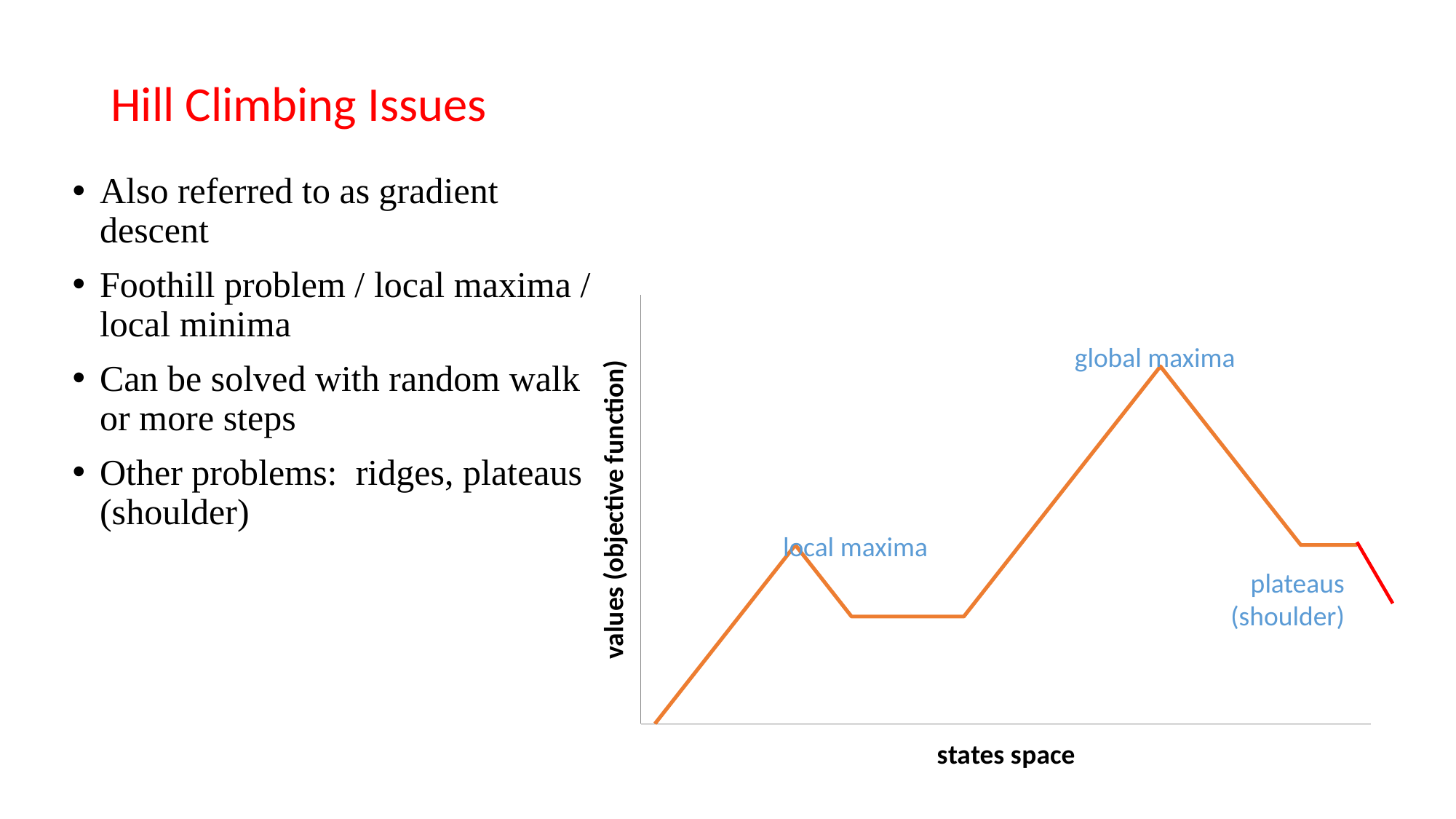
Is the value at the point labeled "global maxima" larger or smaller than the value at the point labeled "local maxima"? larger What kind of chart is shown on the slide? line chart How many flat (plateau) segments does the line have? 2 What is the title of the x axis of the chart? states space Which labeled point on the chart has the highest value: local maxima or global maxima? global maxima What is the title of the y axis of the chart? values (objective function) Does the line rise or fall between the start of the chart and the point labeled "local maxima"? rise Does the line rise or fall at the far right end of the chart, after the plateau labeled "plateaus (shoulder)"? fall Is the flat segment after the local maxima higher or lower than the local maxima point? lower Does the line rise or fall immediately after the point labeled "global maxima"? fall How many labeled features (annotations) are marked on the line? 3